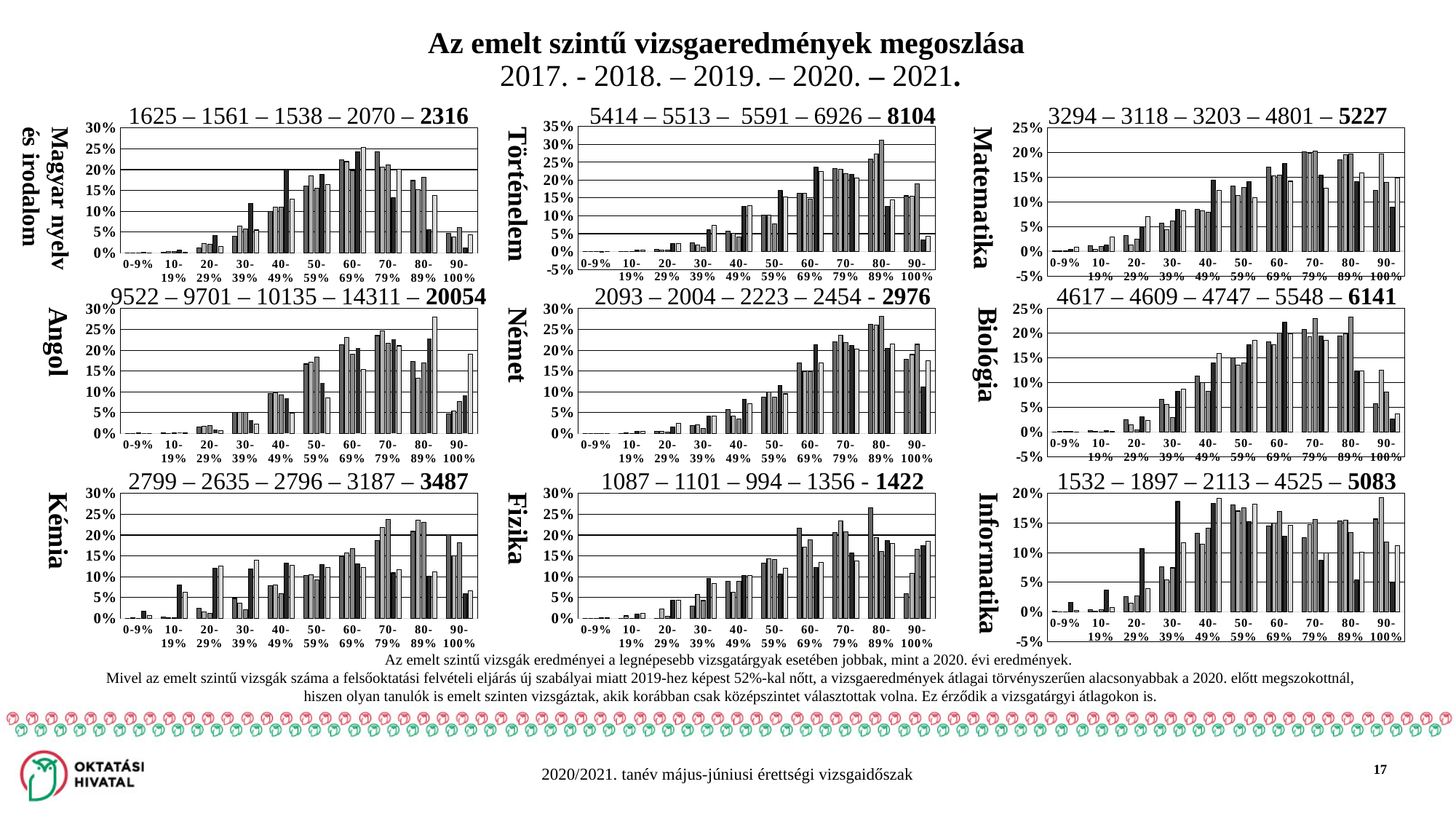
In the Német chart, is the tallest bar in the 80-89% band greater or less than 25%? greater What is the bold number at the end of the title above the Angol chart? 20054 In the Matematika chart, are the bars for the 10-19% band greater or less than 5%? less In the Fizika chart, are the bars for the 0-9% band greater or less than 5%? less How many score-band categories are shown on the x axis of the Angol chart? 10 How many charts are shown on the slide? 9 What kind of chart is the Kémia chart? bar chart